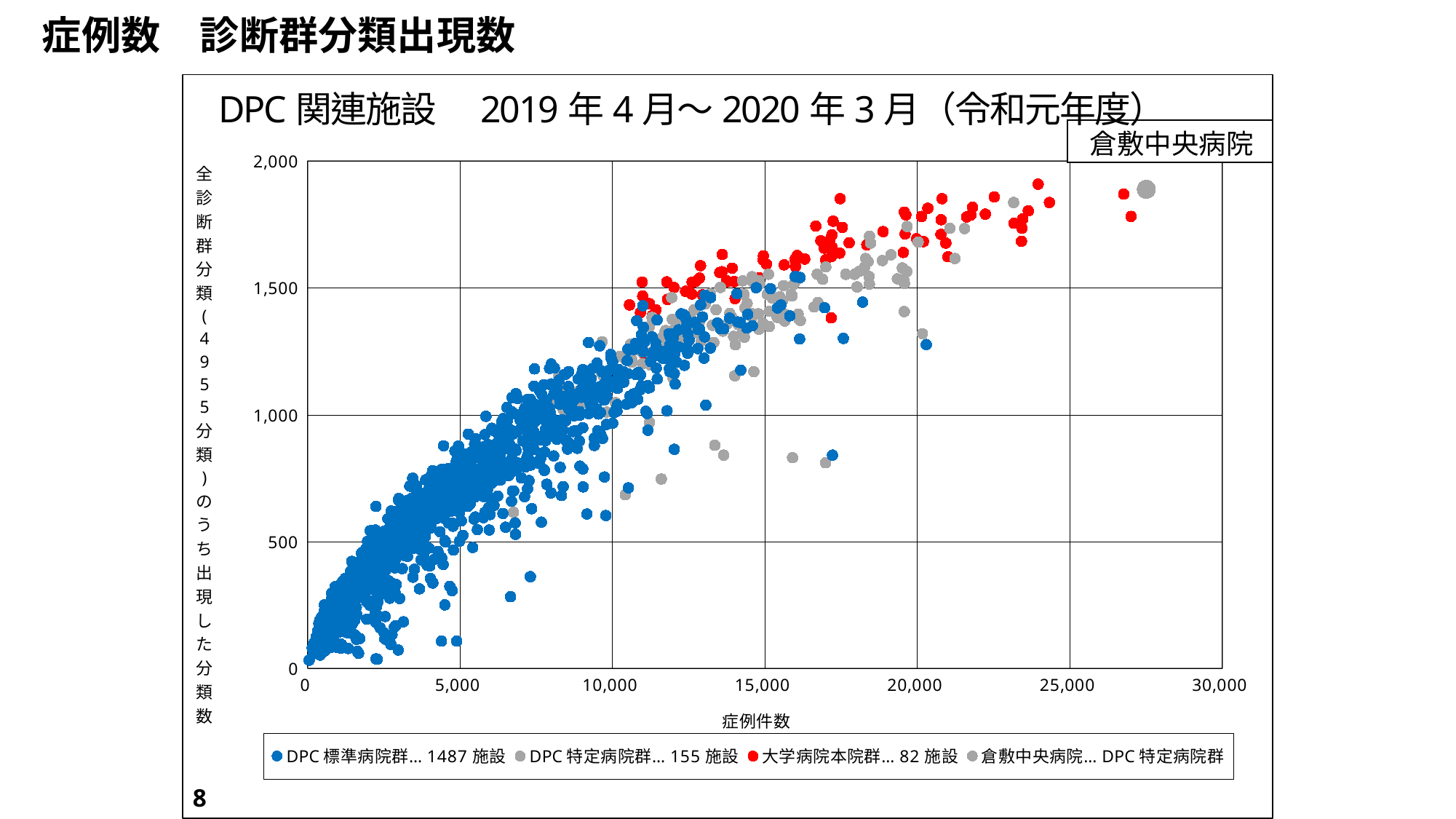
Is the x value (症例件数) for 倉敷中央病院 greater or less than 25,000? greater What is the title of the chart? DPC 関連施設 2019 年 4 月～ 2020 年 3 月（令和元年度） According to the legend, how many facilities are in the DPC 特定病院群 series? 155 施設 According to the legend, how many facilities are in the 大学病院本院群 series? 82 施設 What is the label of the x axis? 症例件数 What is the highest tick value shown on the x axis? 30,000 How many series does the legend list? 4 According to the legend, how many facilities are in the DPC 標準病院群 series? 1487 施設 What kind of chart is shown on the slide? scatter chart Do the plotted values generally rise or fall as 症例件数 increases along the x axis? rise Which series in the legend has the largest number of facilities? DPC 標準病院群 Is the y value for 倉敷中央病院 greater or less than 1,500? greater